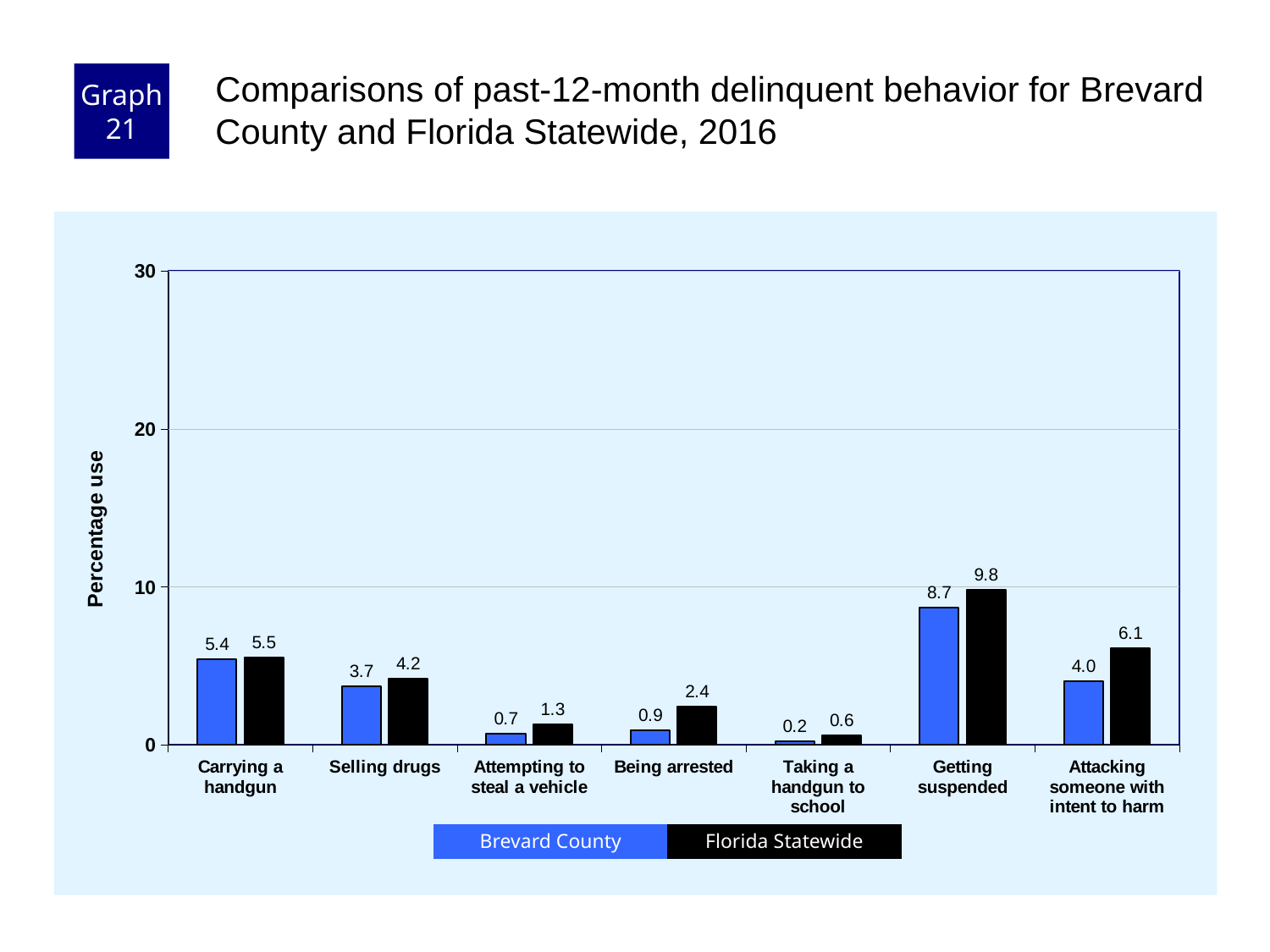
Which category has the lowest Brevard County value? Taking a handgun to school What kind of chart is shown on the slide? bar chart What is the Brevard County value for Getting suspended? 8.7 What is the Florida Statewide value for Attacking someone with intent to harm? 6.1 Which is larger for Selling drugs: the Brevard County value or the Florida Statewide value? Florida Statewide Is the Florida Statewide value for Getting suspended greater or less than 10? less What is the difference between the Florida Statewide and Brevard County values for Attacking someone with intent to harm? 2.1 What is the difference between the Florida Statewide and Brevard County values for Being arrested? 1.5 How many series does the legend list? 2 Which category has the highest Florida Statewide value? Getting suspended How many categories are shown on the x axis? 7 What is the Brevard County value for Taking a handgun to school? 0.2